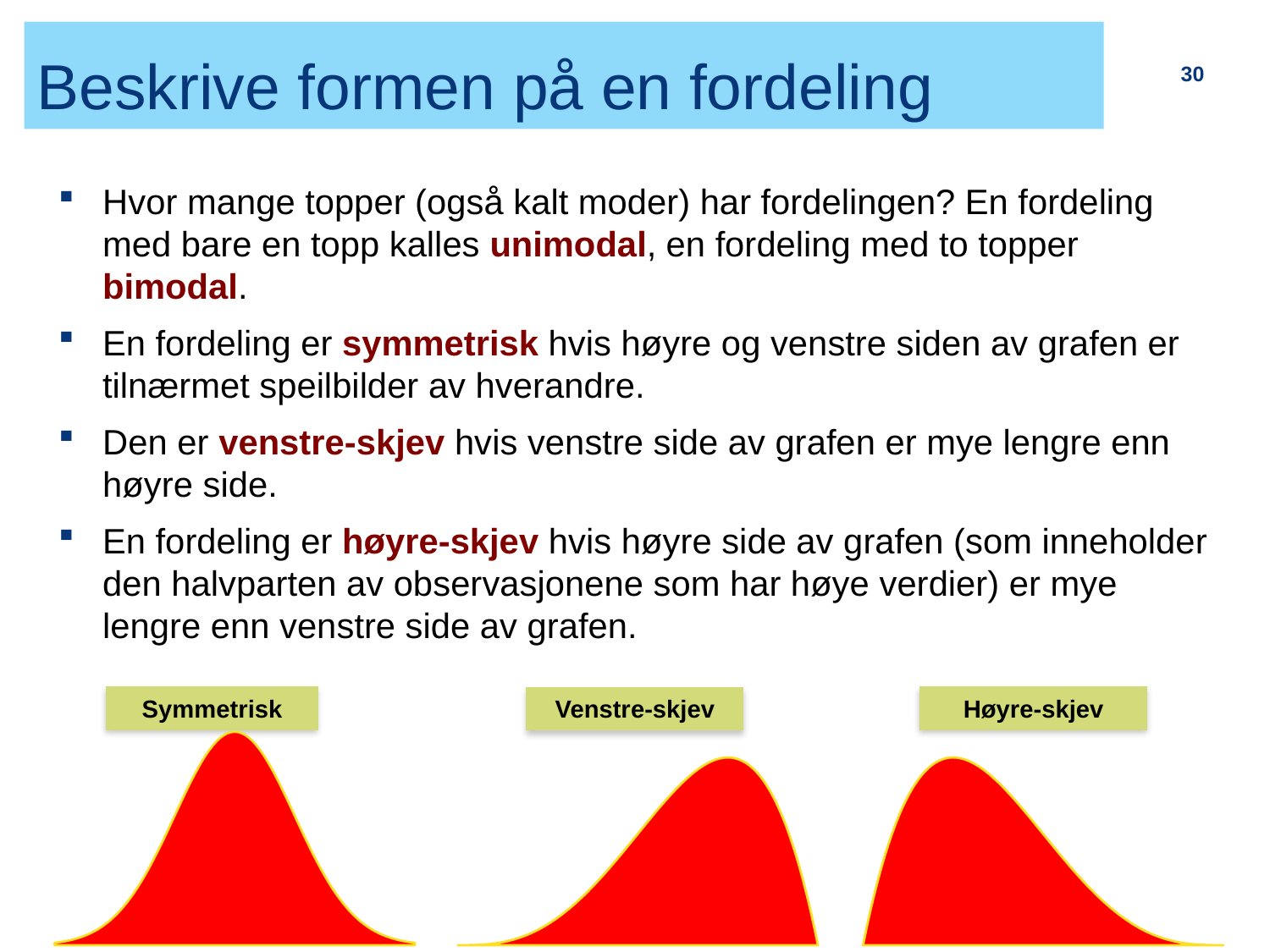
What kind of chart is the one labelled Venstre-skjev? Area chart (filled curve) In the chart labelled Venstre-skjev, is the peak of the curve located toward the left or the right side of the chart? Right In the chart labelled Høyre-skjev, is the peak of the curve located toward the left or the right side of the chart? Left How many distribution charts are shown at the bottom of the slide? 3 What are the labels of the three charts at the bottom of the slide, from left to right? Symmetrisk, Venstre-skjev, Høyre-skjev What fill colour is used for the curves in the three charts? Red Which of the three charts has its peak in the centre of the chart? Symmetrisk What kind of chart is the one labelled Symmetrisk? Area chart (filled curve)